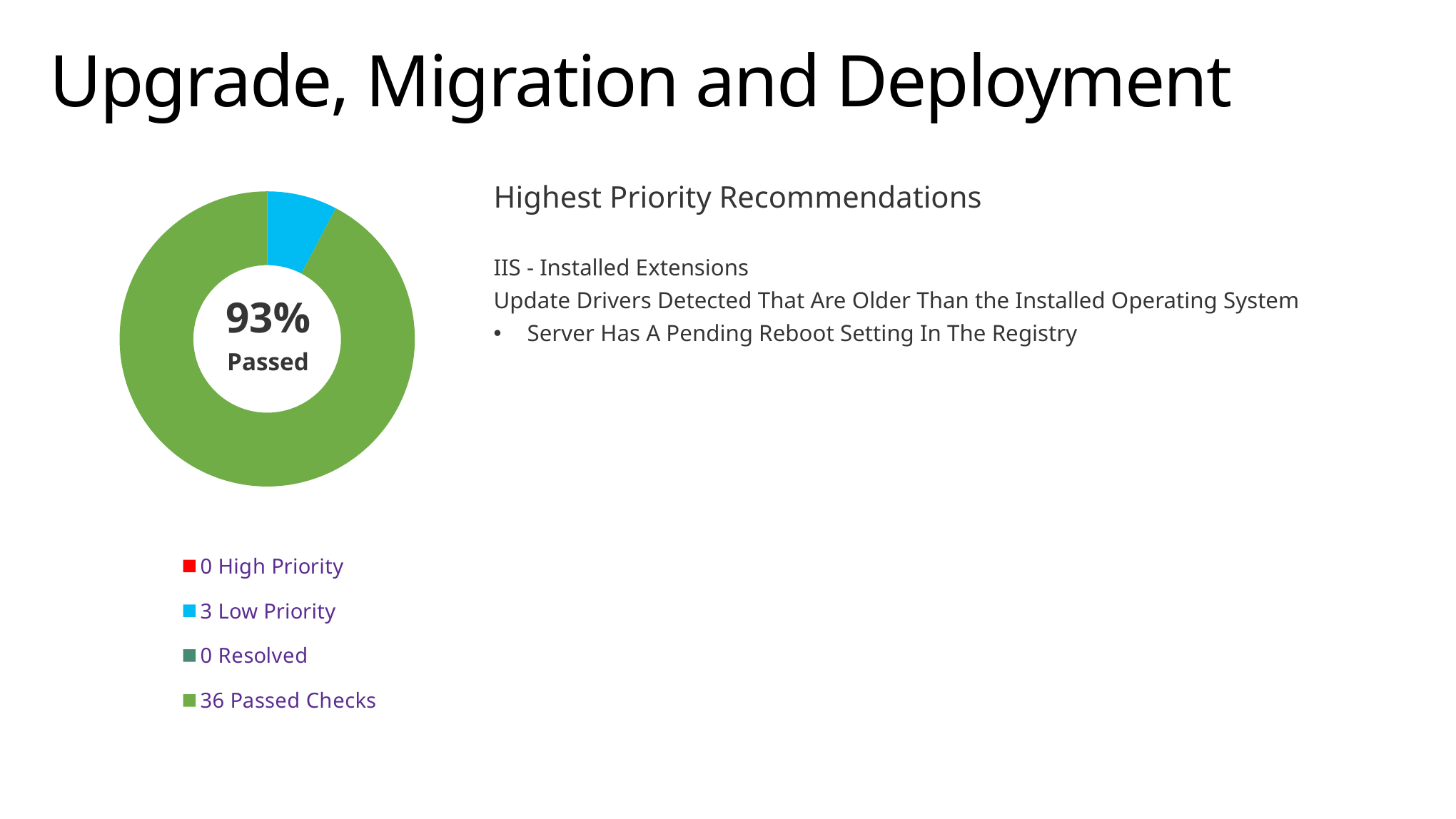
How many Passed Checks does the legend show? 36 Which is larger, Low Priority or High Priority? Low Priority What kind of chart is shown on the slide? Doughnut chart How many categories does the legend list? 4 What percentage is shown in the centre of the doughnut chart? 93% What is the total of all the values listed in the legend? 39 Which category has the highest value in the chart? Passed Checks What colour represents Passed Checks in the chart? Green How many Resolved items does the legend show? 0 How many High Priority items does the legend show? 0 How many Low Priority items does the legend show? 3 What is the difference between the number of Passed Checks and Low Priority items? 33